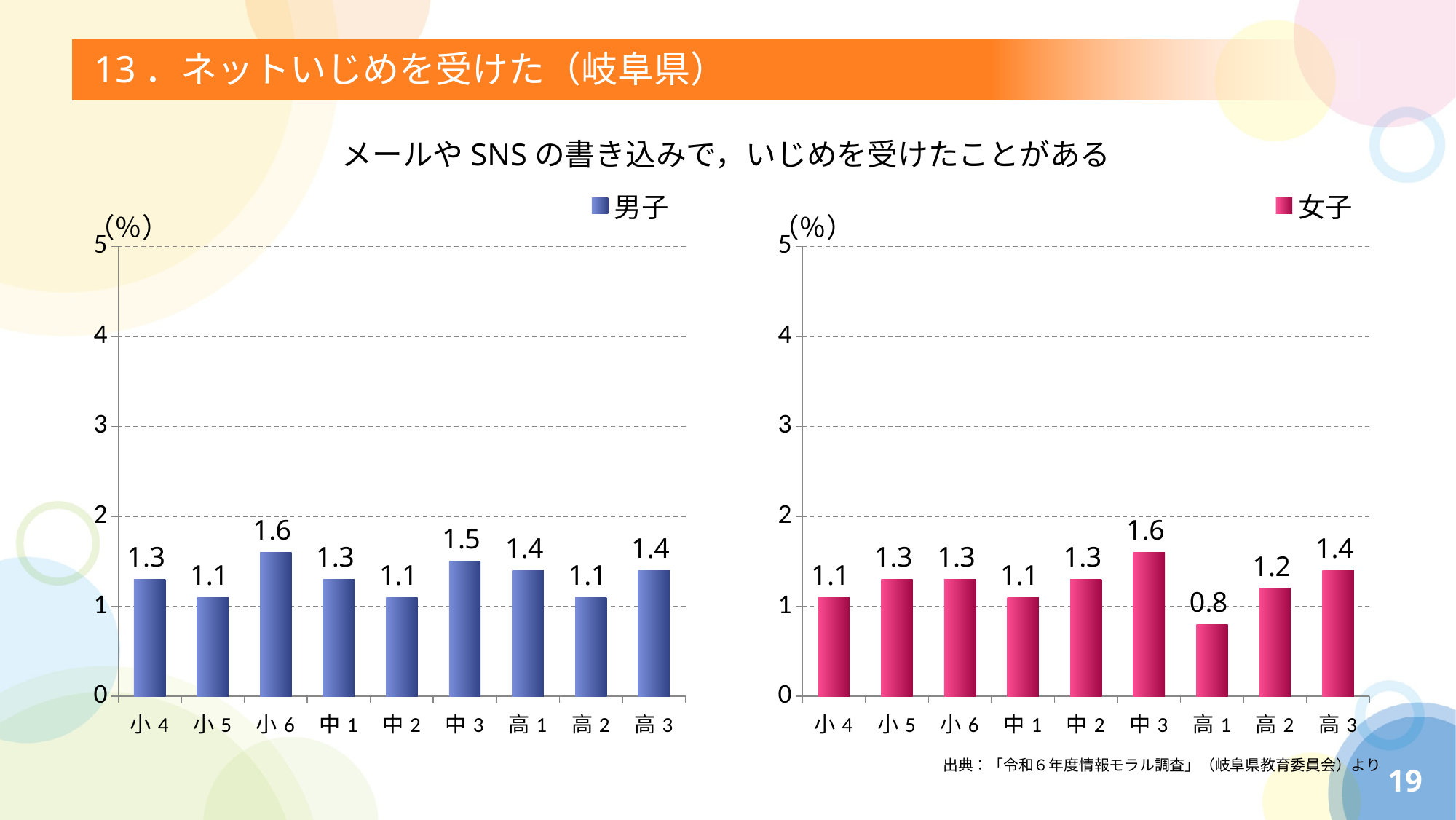
In the 男子 chart, which category has the highest value? 小6 In the 男子 chart, which is larger, the value for 中3 or the value for 中2? 中3 How many categories are shown on the x axis of the 男子 chart? 9 In the 男子 chart, what is the difference between the values for 小6 and 小5? 0.5 In the 女子 chart, is the value for 高3 greater or less than 2? less What unit is shown on the y axis of the 男子 chart? (%) In the 女子 chart, what is the value for 高1? 0.8 In the 男子 chart, what is the value for 小6? 1.6 What kind of chart is the 女子 chart? bar chart In the 女子 chart, what is the difference between the values for 中3 and 高1? 0.8 In the 女子 chart, which category has the lowest value? 高1 In the 女子 chart, which category has the highest value? 中3